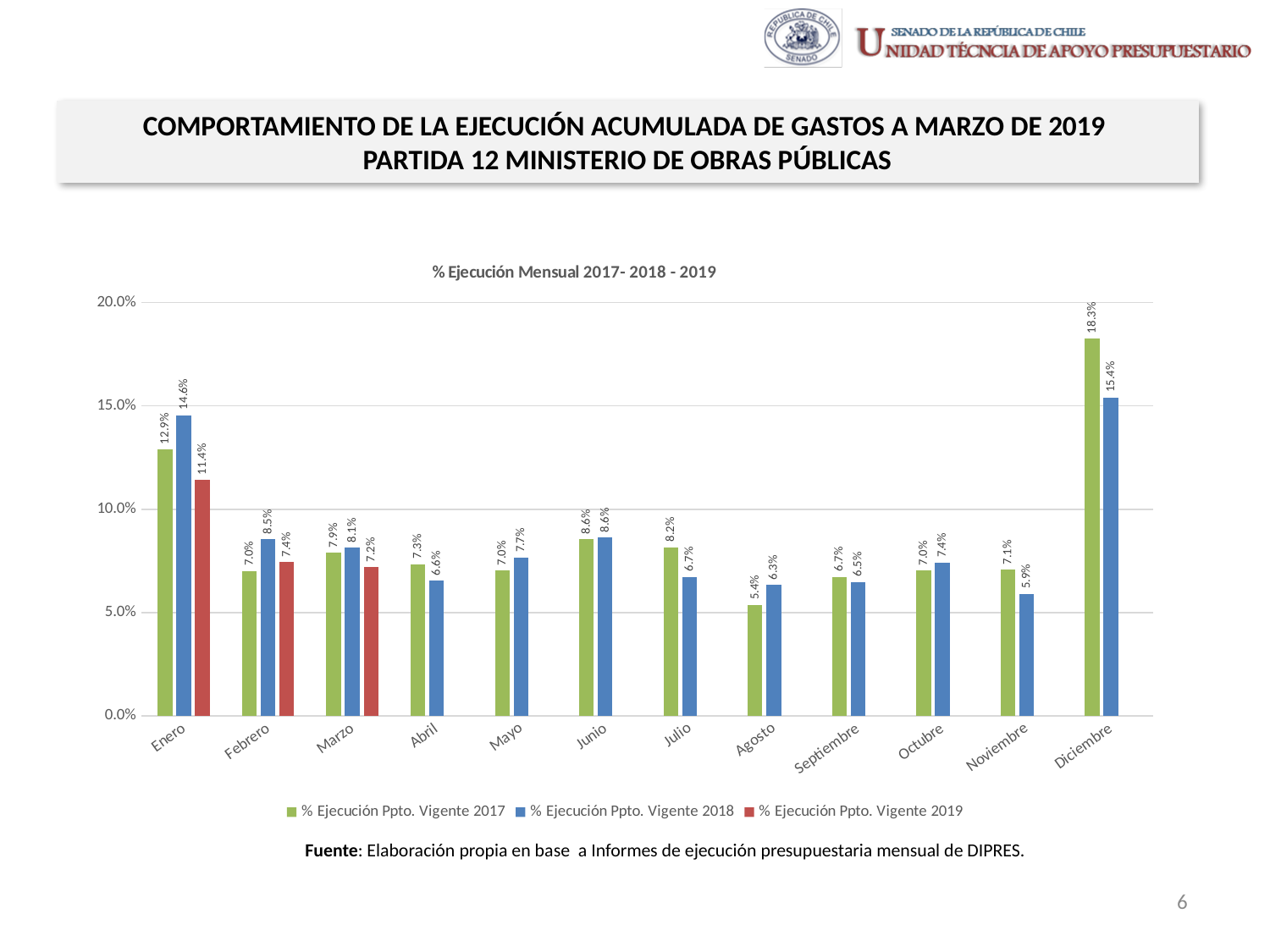
What is the title of the chart? % Ejecución Mensual 2017- 2018 - 2019 Is the value of % Ejecución Ppto. Vigente 2019 for Enero greater or less than 10.0%? greater Which is larger for Febrero: the 2018 value or the 2019 value? 2018 value (8.5%) How many months are shown on the x axis? 12 Which month has the highest value for % Ejecución Ppto. Vigente 2017? Diciembre What is the value of % Ejecución Ppto. Vigente 2018 for Enero? 14.6% What is the value of % Ejecución Ppto. Vigente 2019 for Marzo? 7.2% What kind of chart is shown on the slide? Bar chart How many series does the legend list? 3 What is the difference between the 2017 and 2018 values for Diciembre? 2.9% What is the value of % Ejecución Ppto. Vigente 2017 for Diciembre? 18.3% Which month has the lowest value for % Ejecución Ppto. Vigente 2018? Noviembre